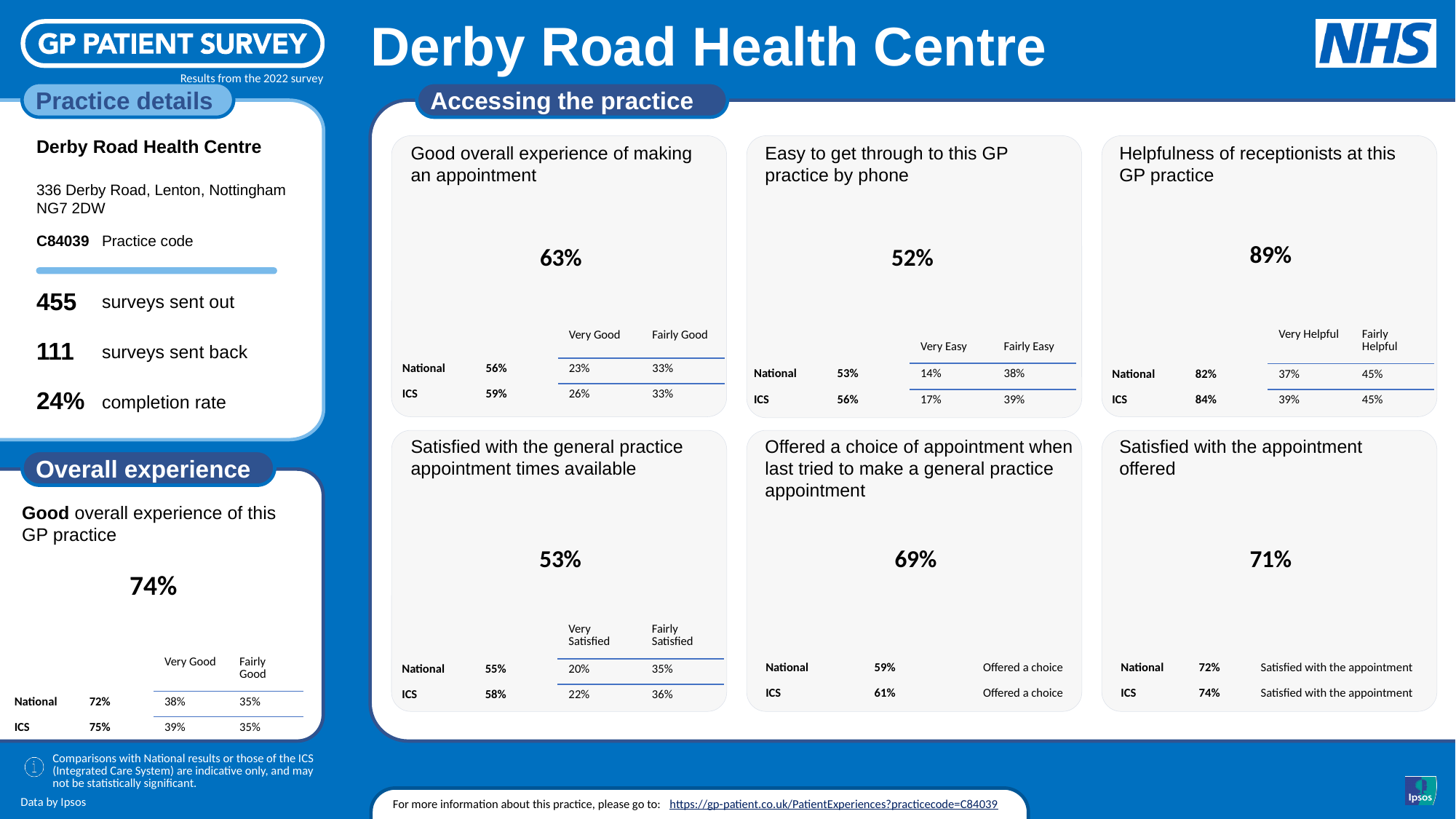
In the 'Overall experience' section, what is the practice's 'Good overall experience of this GP practice' percentage? 74% In the 'Satisfied with the appointment offered' panel, what is the difference between the ICS value and the National value? 2% In the 'Easy to get through to this GP practice by phone' panel, what is the difference between the practice value and the ICS value? 4% In the 'Offered a choice of appointment when last tried to make a general practice appointment' panel, which is larger: the practice value or the National value? The practice value (69%) How many measure panels are shown in the 'Accessing the practice' section? 6 In the 'Easy to get through to this GP practice by phone' panel, what is the National value? 53% In the 'Helpfulness of receptionists at this GP practice' panel, what is the ICS 'Very Helpful' value? 39% Which two comparison rows are listed beneath each measure panel? National and ICS In the 'Good overall experience of making an appointment' panel, what is the practice's headline percentage? 63% Across the six 'Accessing the practice' panels, which measure has the lowest practice percentage? Easy to get through to this GP practice by phone Across the six 'Accessing the practice' panels, which measure has the highest practice percentage? Helpfulness of receptionists at this GP practice In the 'Satisfied with the general practice appointment times available' panel, what is the total of the National 'Very Satisfied' and 'Fairly Satisfied' values? 55%